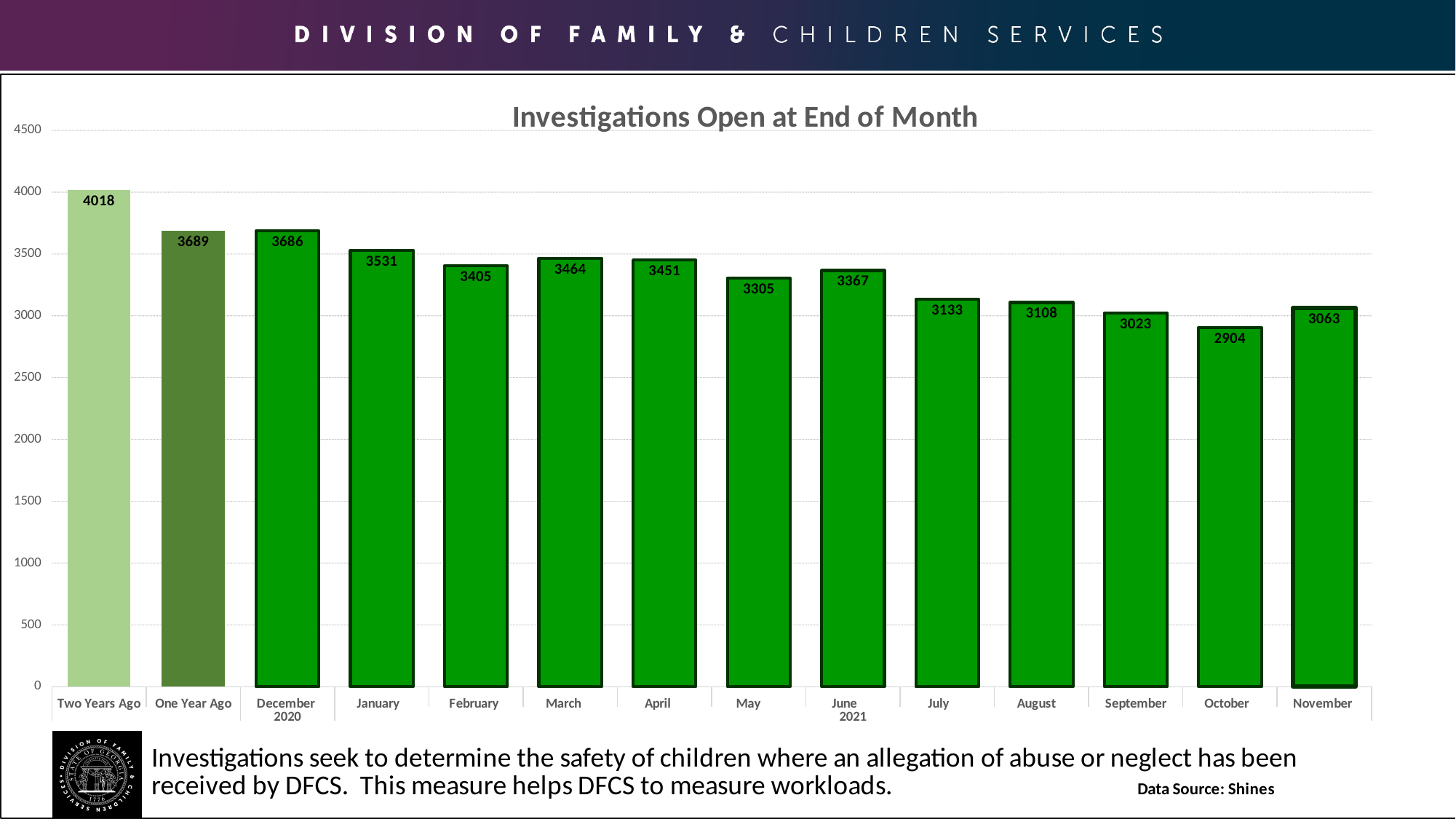
What is the difference between the One Year Ago value and the November value? 626 How many investigations were open at the end of October? 2904 What is the value shown for June 2021? 3367 How many categories are shown on the x axis of the chart? 14 What kind of chart is shown on the slide? bar chart Do the values generally rise or fall from December 2020 to October? fall What is the value for Two Years Ago in the Investigations Open at End of Month chart? 4018 What is the difference between the March and May values? 159 Which category has the highest value in the chart? Two Years Ago Is the value for September greater or less than 3500? less Which category has the lowest value in the chart? October Which is larger, the value for January or the value for February? January